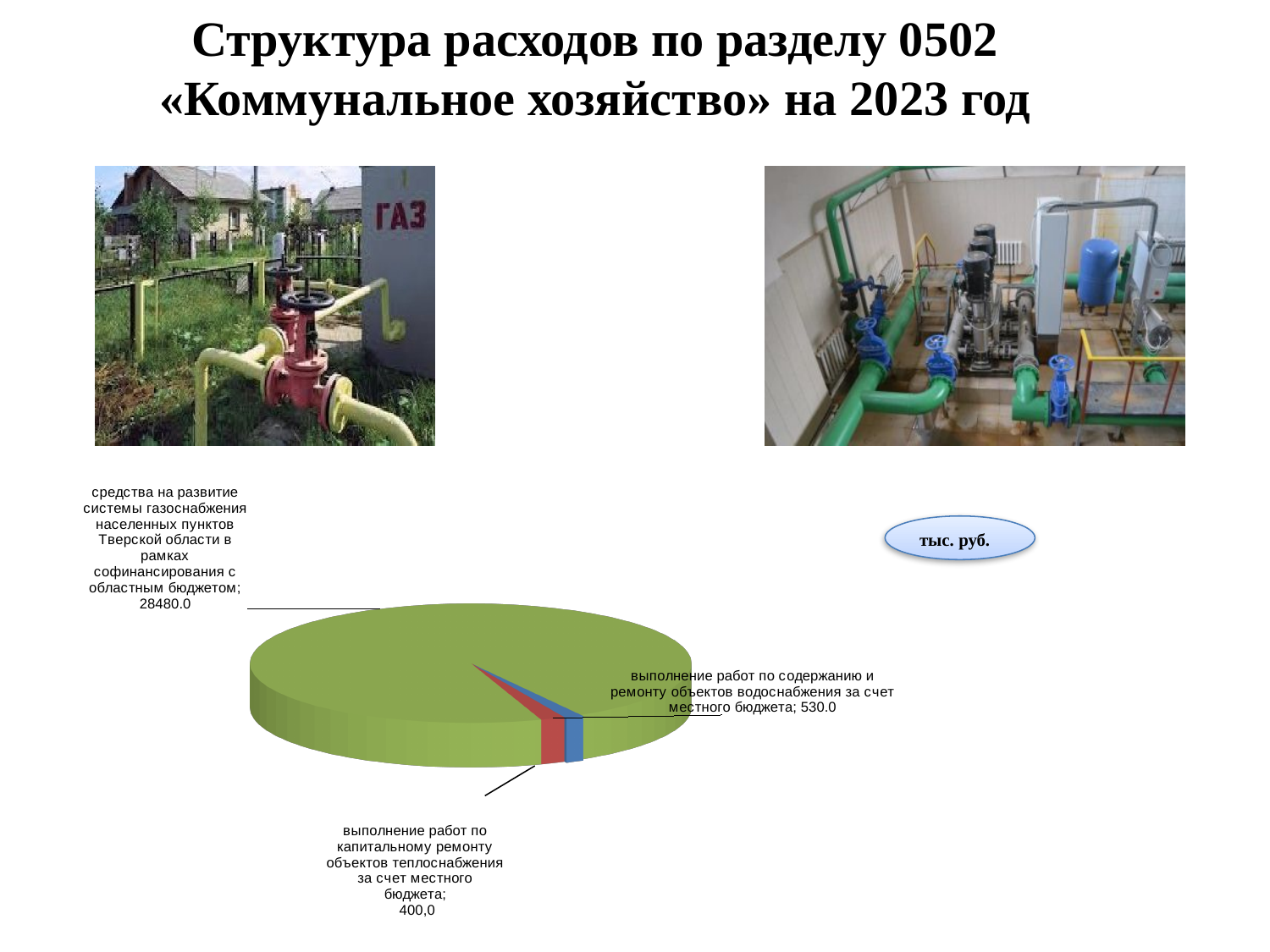
What is the value for «выполнение работ по содержанию и ремонту объектов водоснабжения за счет местного бюджета»? 530.0 Which category has the largest slice of the pie? средства на развитие системы газоснабжения населенных пунктов Тверской области в рамках софинансирования с областным бюджетом What is the title of the slide containing the chart? Структура расходов по разделу 0502 «Коммунальное хозяйство» на 2023 год What is the value for «выполнение работ по капитальному ремонту объектов теплоснабжения за счет местного бюджета»? 400,0 How many slices does the pie chart have? 3 What kind of chart is shown on the slide? pie chart What is the difference between the value for gas supply development (28480.0) and the value for water supply maintenance (530.0)? 27950.0 Which is larger: the value for water supply maintenance and repair (водоснабжения) or for capital repair of heating facilities (теплоснабжения)? водоснабжения (530.0) Which category has the smallest slice of the pie? выполнение работ по капитальному ремонту объектов теплоснабжения за счет местного бюджета In what units are the values on the chart given, according to the label on the slide? тыс. руб. What is the value for «средства на развитие системы газоснабжения населенных пунктов Тверской области в рамках софинансирования с областным бюджетом»? 28480.0 What is the difference between the value for water supply maintenance (530.0) and the value for heating capital repair (400,0)? 130.0